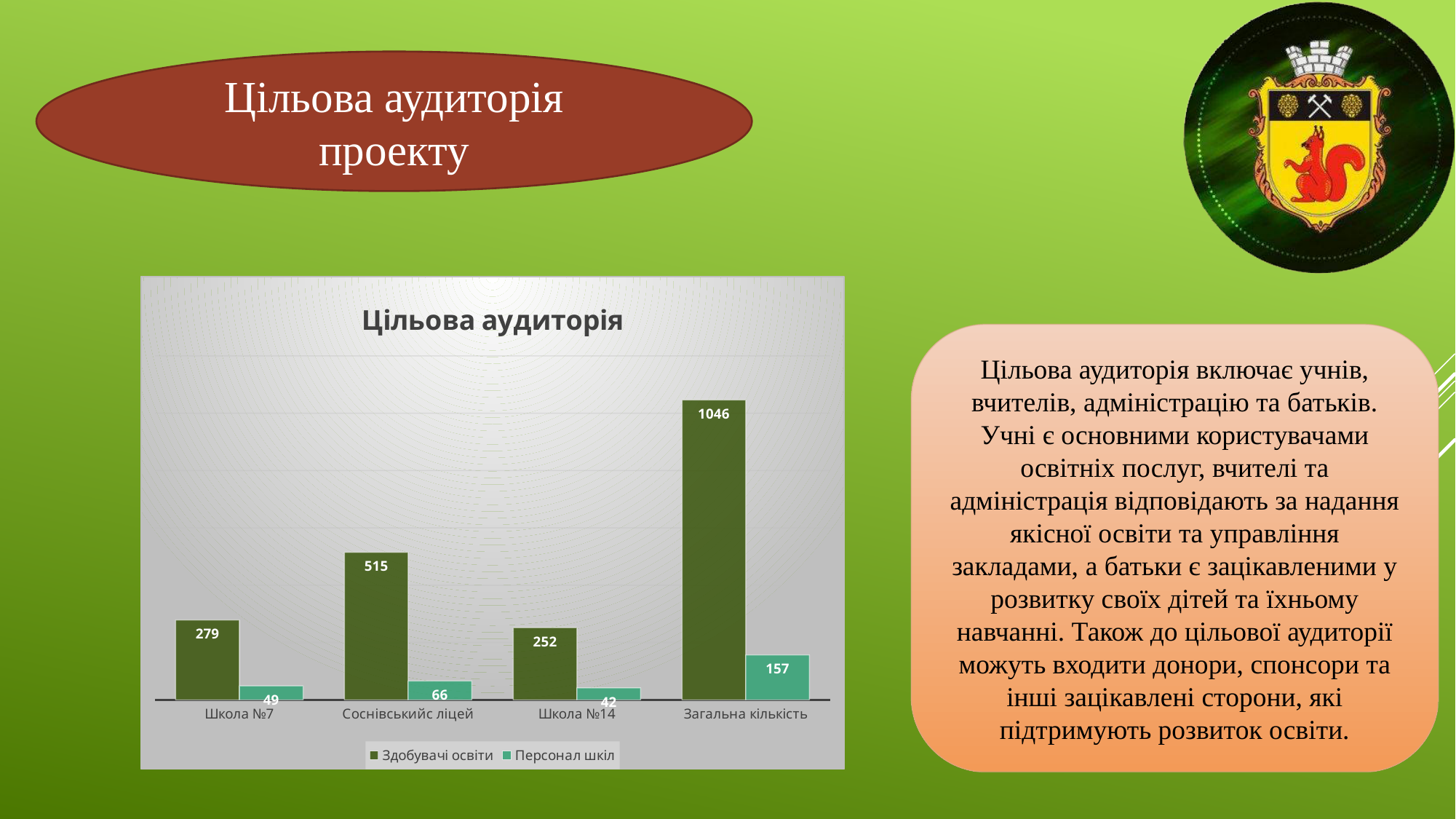
What is the title of the chart? Цільова аудиторія What is the value of Персонал шкіл for Школа №14? 42 What is the value of Здобувачі освіти for Школа №7? 279 What is the value of Здобувачі освіти for Загальна кількість? 1046 Which category has the highest value for Здобувачі освіти? Загальна кількість Which category has the lowest value for Персонал шкіл? Школа №14 How many categories are shown on the x axis? 4 What type of chart is shown on the slide? Bar chart How many series does the legend list? 2 Which is larger: Персонал шкіл for Школа №7 or for Соснівськийс ліцей? Соснівськийс ліцей What is the difference between Здобувачі освіти for Соснівськийс ліцей and for Школа №7? 236 What is the value of Персонал шкіл for Соснівськийс ліцей? 66